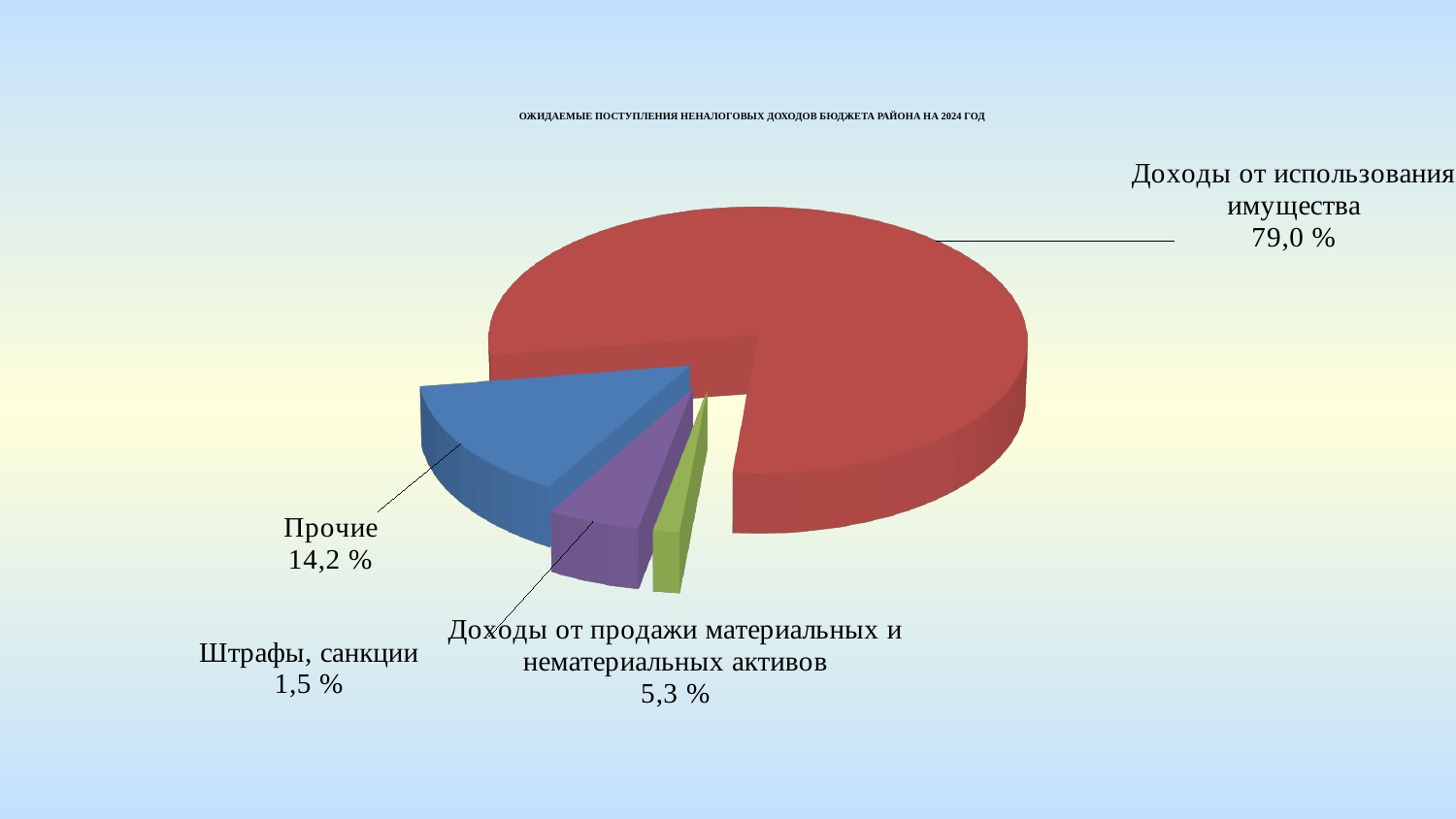
What is the difference between the shares of "Доходы от продажи материальных и нематериальных активов" and "Штрафы, санкции"? 3,8 % What is the value shown for "Доходы от продажи материальных и нематериальных активов"? 5,3 % Which category has the smallest slice of the pie? Штрафы, санкции What share of the pie does "Доходы от использования имущества" have? 79,0 % Which is larger: the share of "Прочие" or the share of "Доходы от продажи материальных и нематериальных активов"? Прочие What is the value shown for "Прочие"? 14,2 % What is the difference between the shares of "Доходы от использования имущества" and "Прочие"? 64,8 % What kind of chart is shown on the slide? Pie chart What colour is the slice for "Прочие"? Blue Which category has the largest slice of the pie? Доходы от использования имущества How many slices does the pie chart have? 4 What is the value shown for "Штрафы, санкции"? 1,5 %